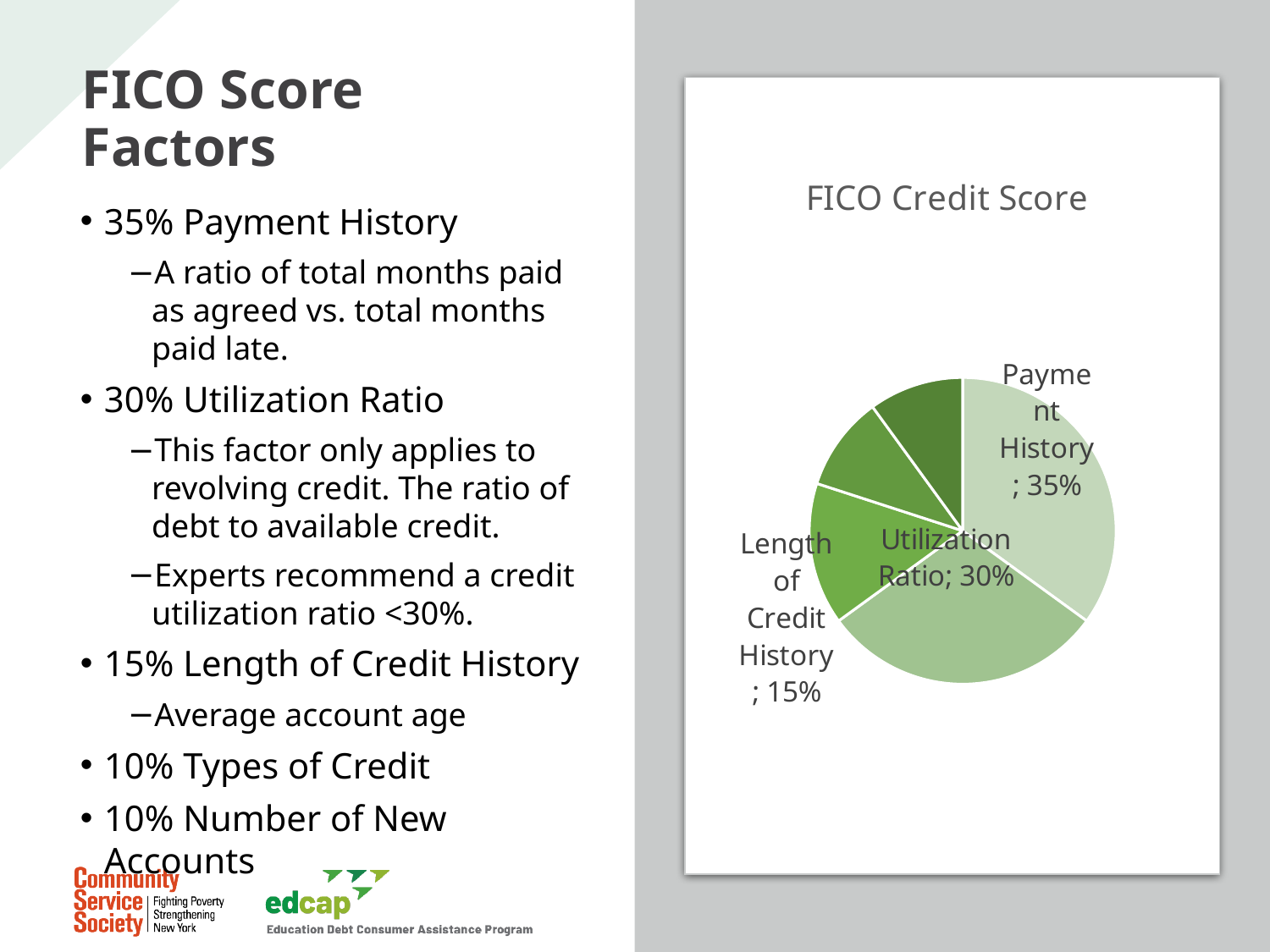
What is the title of the chart? FICO Credit Score Which labeled slice of the pie is the smallest? Length of Credit History What share of the pie does Length of Credit History represent? 15% What share of the pie does Utilization Ratio represent? 30% Which is larger, the Payment History slice or the Utilization Ratio slice? Payment History What kind of chart is shown on the slide? pie chart How many slices does the pie chart have? 5 What is the combined share of Payment History and Utilization Ratio? 65% Which labeled slice of the pie is the largest? Payment History What share of the pie does Payment History represent? 35% What is the difference between the Utilization Ratio share and the Length of Credit History share? 15% What is the difference between the Payment History share and the Length of Credit History share? 20%